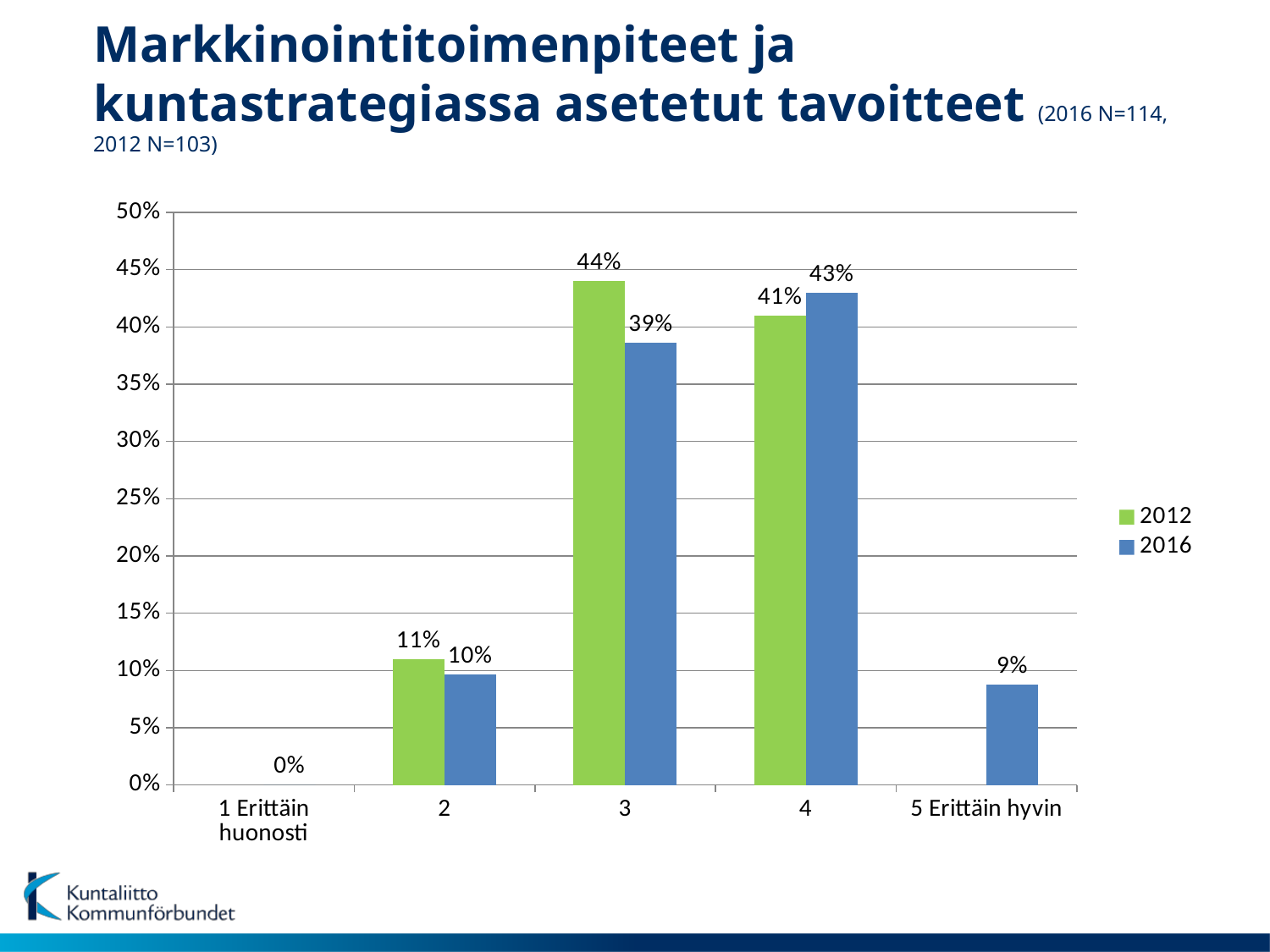
Is the 2016 value for category 3 greater or less than 35%? greater What is the 2016 value for category 4? 43% Which category has the highest 2012 value? 3 What is the 2016 value for '5 Erittäin hyvin'? 9% What is the difference between the 2012 and 2016 values for category 3? 5% How many categories are shown on the x axis? 5 What kind of chart is shown on the slide? Bar chart Which category has the highest 2016 value? 4 For category 4, which series has the larger value, 2012 or 2016? 2016 What is the 2016 value for category 2? 10% What is the 2012 value for category 3? 44% How many series does the legend list? 2